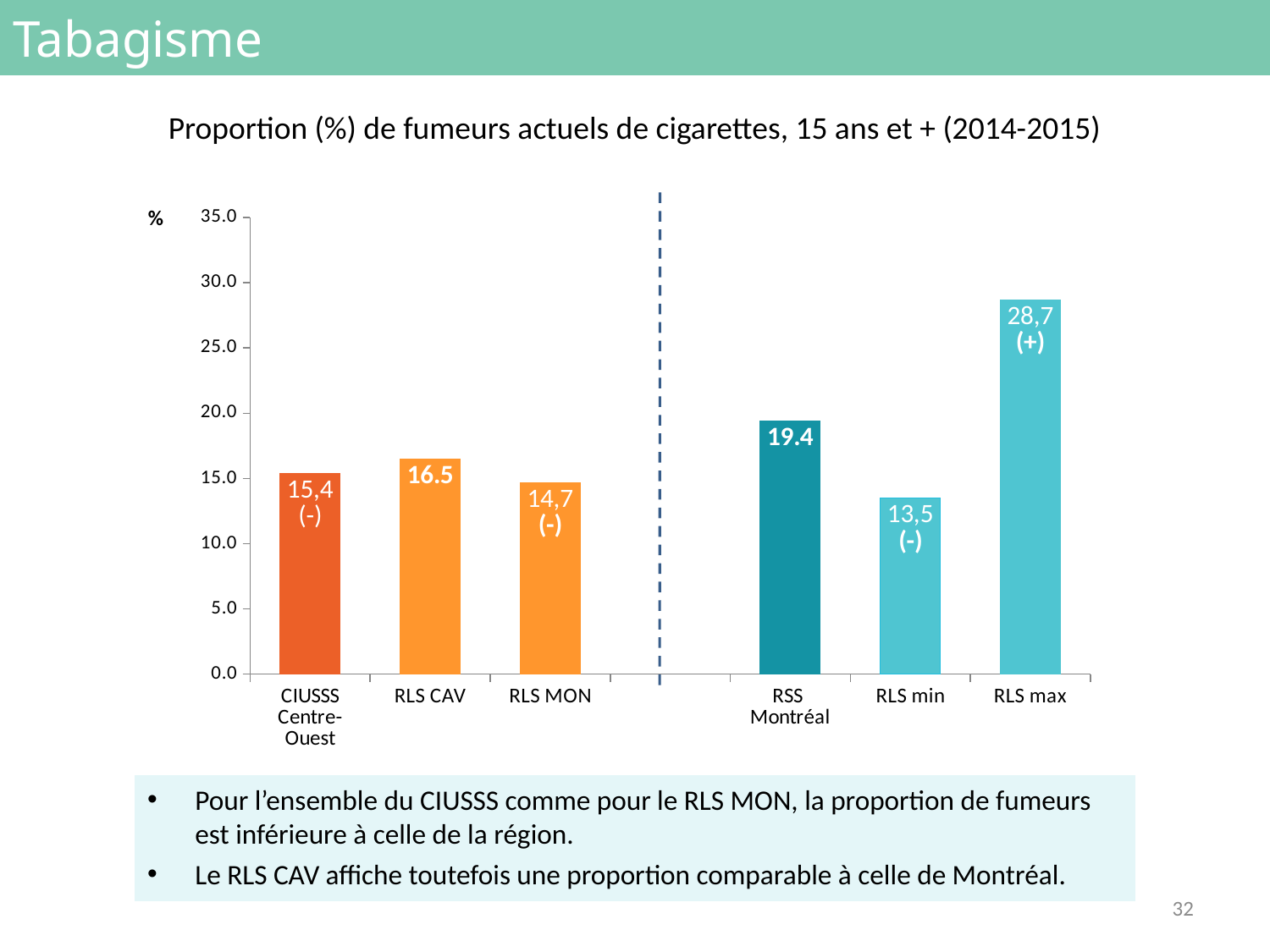
Which is larger, the value for RLS CAV or the value for CIUSSS Centre-Ouest? RLS CAV What is the value for RLS CAV? 16.5 What is the value for RLS MON? 14,7 What type of chart is shown on the slide? bar chart What is the value for CIUSSS Centre-Ouest? 15,4 What is the difference between the values for RLS max and RLS min? 15,2 What is the value for RSS Montréal? 19.4 What is the title of the chart? Proportion (%) de fumeurs actuels de cigarettes, 15 ans et + (2014-2015) Which category has the highest value? RLS max How many categories are shown on the x axis? 6 Which category has the lowest value? RLS min Is the value for RLS max greater or less than 25.0? greater